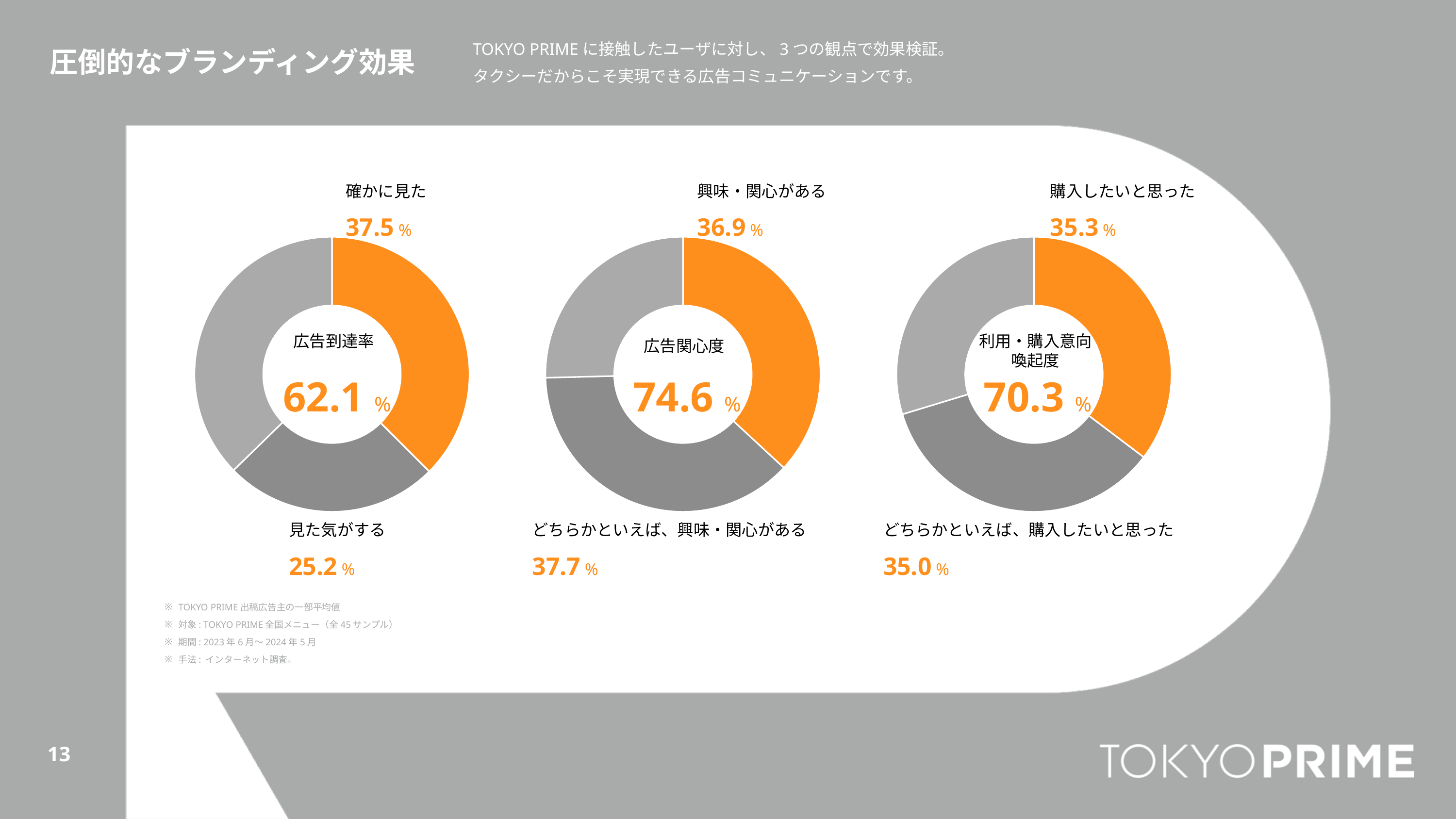
How many donut charts are shown on the slide? 3 In the 利用・購入意向喚起度 chart, what is the combined total shown in the centre? 70.3% In the 広告到達率 chart, which is larger, 確かに見た or 見た気がする? 確かに見た In the 広告関心度 chart, what is the combined total of the two orange-labelled slices shown in the centre? 74.6% In the 広告到達率 chart, what is the value for 見た気がする? 25.2% In the 広告関心度 chart, what is the value for 興味・関心がある? 36.9% What kind of chart is used for 広告到達率? Donut (pie) chart In the 広告到達率 chart, what is the difference between 確かに見た and 見た気がする? 12.3 percentage points In the 広告到達率 chart, what is the value for 確かに見た? 37.5% In the 利用・購入意向喚起度 chart, what is the value for 購入したいと思った? 35.3% In the 広告関心度 chart, what is the value for どちらかといえば、興味・関心がある? 37.7% In the 利用・購入意向喚起度 chart, what is the value for どちらかといえば、購入したいと思った? 35.0%